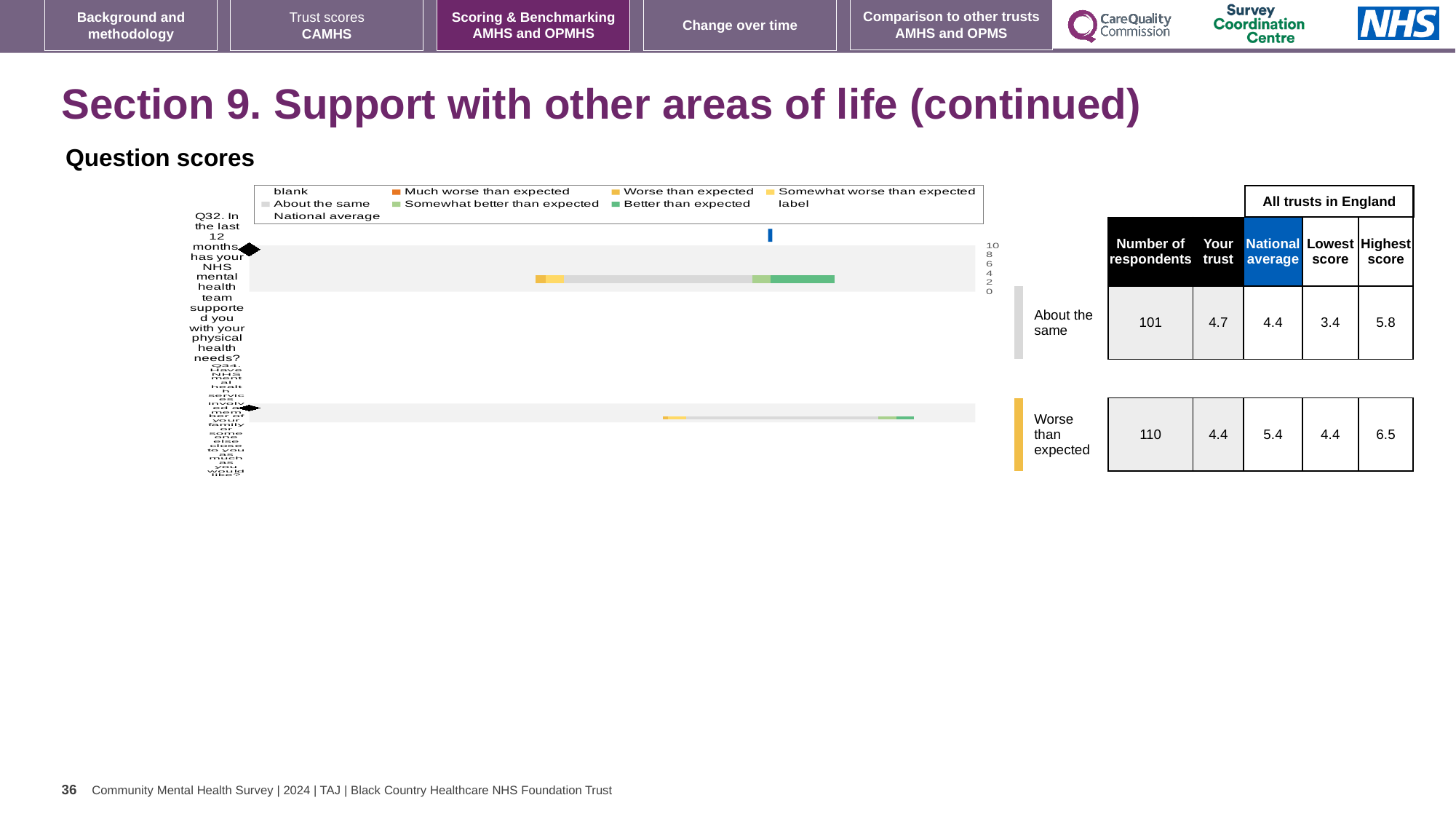
What is the lowest score among all trusts in England for Q32? 3.4 What kind of chart is used to show the question scores on this slide? bar chart What benchmark category is shown for Q34? Worse than expected What is the number of respondents for Q32 (support with physical health needs)? 101 What is the 'Your trust' score for Q32? 4.7 Which question has the larger number of respondents, Q32 or Q34? Q34 What is the national average score for Q34 (involving family or someone close)? 5.4 What is the highest score among all trusts in England for Q34? 6.5 For Q32, which is larger: the 'Your trust' score or the national average? Your trust How many survey questions are plotted in the question scores chart? 2 For Q34, what is the difference between the highest score and the lowest score? 2.1 What benchmark category is shown for Q32? About the same